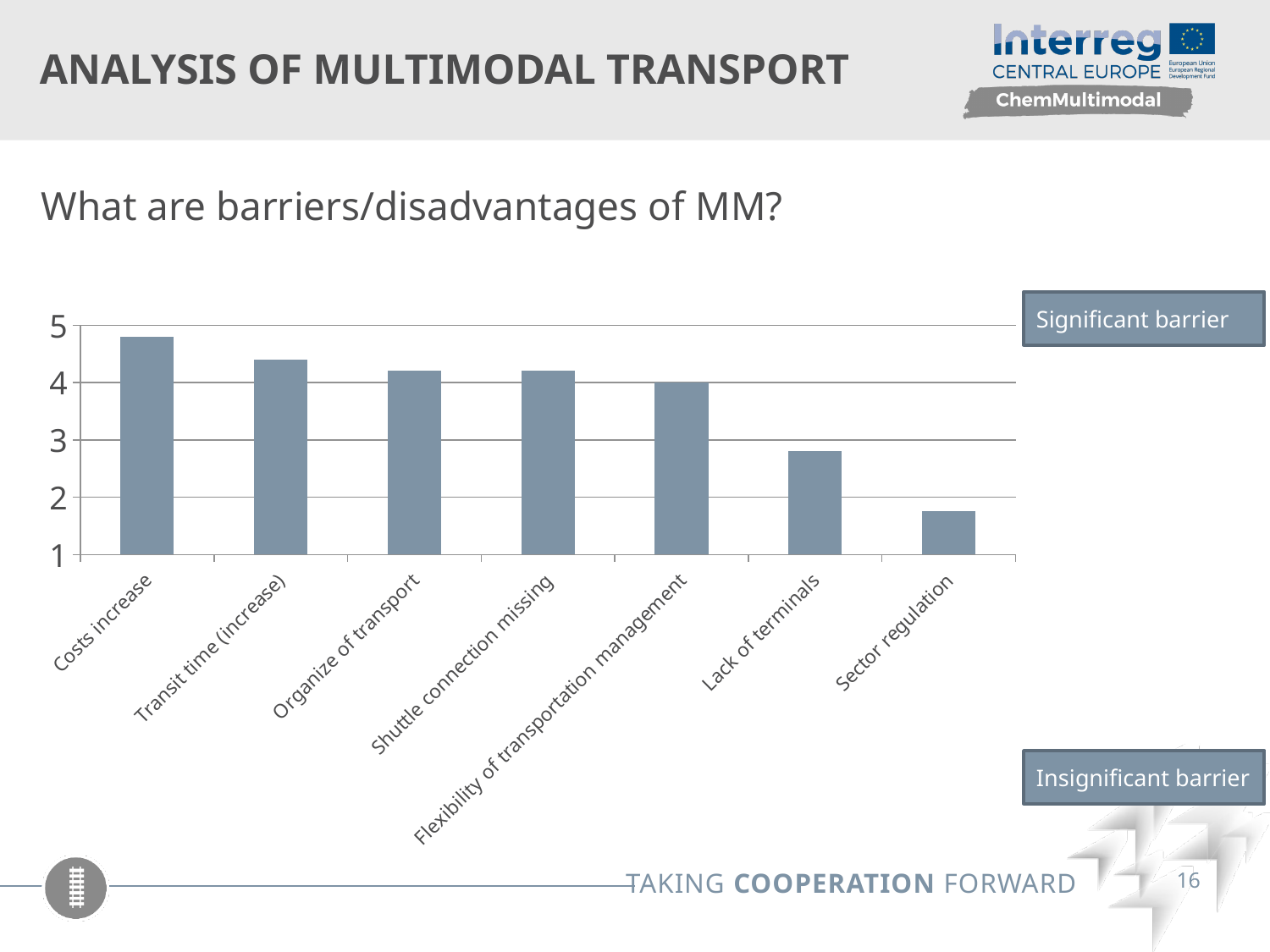
What label appears in the box at the top right of the chart, next to the value 5? Significant barrier Do the bar values rise or fall from left to right along the x axis? fall Which has the larger value: Costs increase or Lack of terminals? Costs increase Which has the larger value: Transit time (increase) or Sector regulation? Transit time (increase) How many barrier categories are plotted on the chart? 7 Is the value for Sector regulation greater or less than 2? less Which barrier has the lowest value on the chart? Sector regulation What question does the heading above the chart ask? What are barriers/disadvantages of MM? Is the value for Lack of terminals greater or less than 3? less Is the value for Costs increase greater or less than 4? greater What kind of chart is shown on the slide? bar chart Which barrier has the highest value on the chart? Costs increase